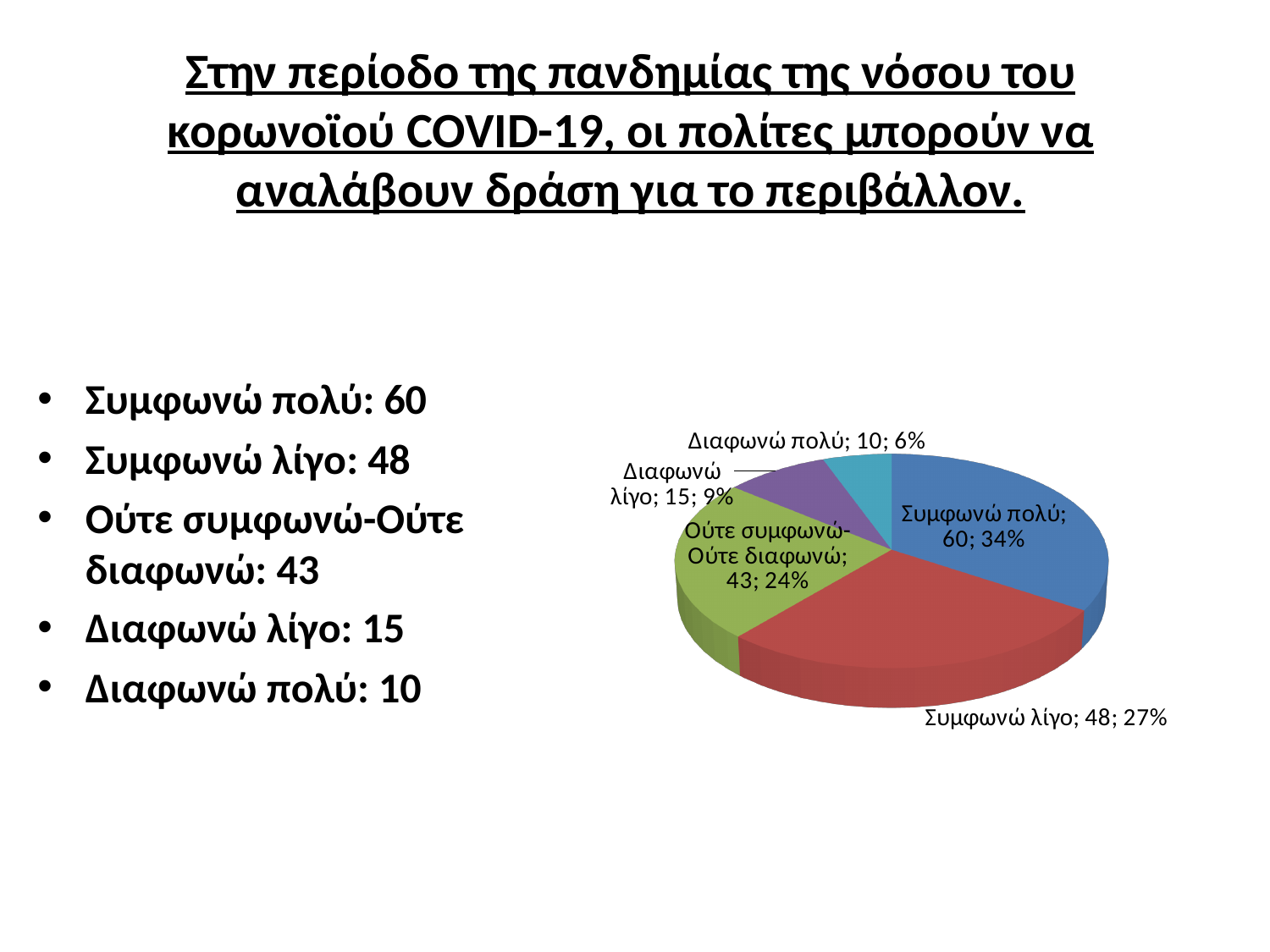
What is the difference between the values for Συμφωνώ πολύ and Συμφωνώ λίγο? 12 What percentage share does Διαφωνώ πολύ have in the pie chart? 6% Which category has the largest slice in the pie chart? Συμφωνώ πολύ Which is larger, the value for Ούτε συμφωνώ-Ούτε διαφωνώ or the value for Διαφωνώ λίγο? Ούτε συμφωνώ-Ούτε διαφωνώ What percentage share does Συμφωνώ λίγο have in the pie chart? 27% What kind of chart is shown on the slide? Pie chart What colour is the Συμφωνώ πολύ slice in the pie chart? Blue What is the value for Ούτε συμφωνώ-Ούτε διαφωνώ in the pie chart? 43 Which category has the smallest slice in the pie chart? Διαφωνώ πολύ How many categories are shown in the pie chart? 5 What is the value for Συμφωνώ πολύ in the pie chart? 60 What is the value for Διαφωνώ λίγο in the pie chart? 15